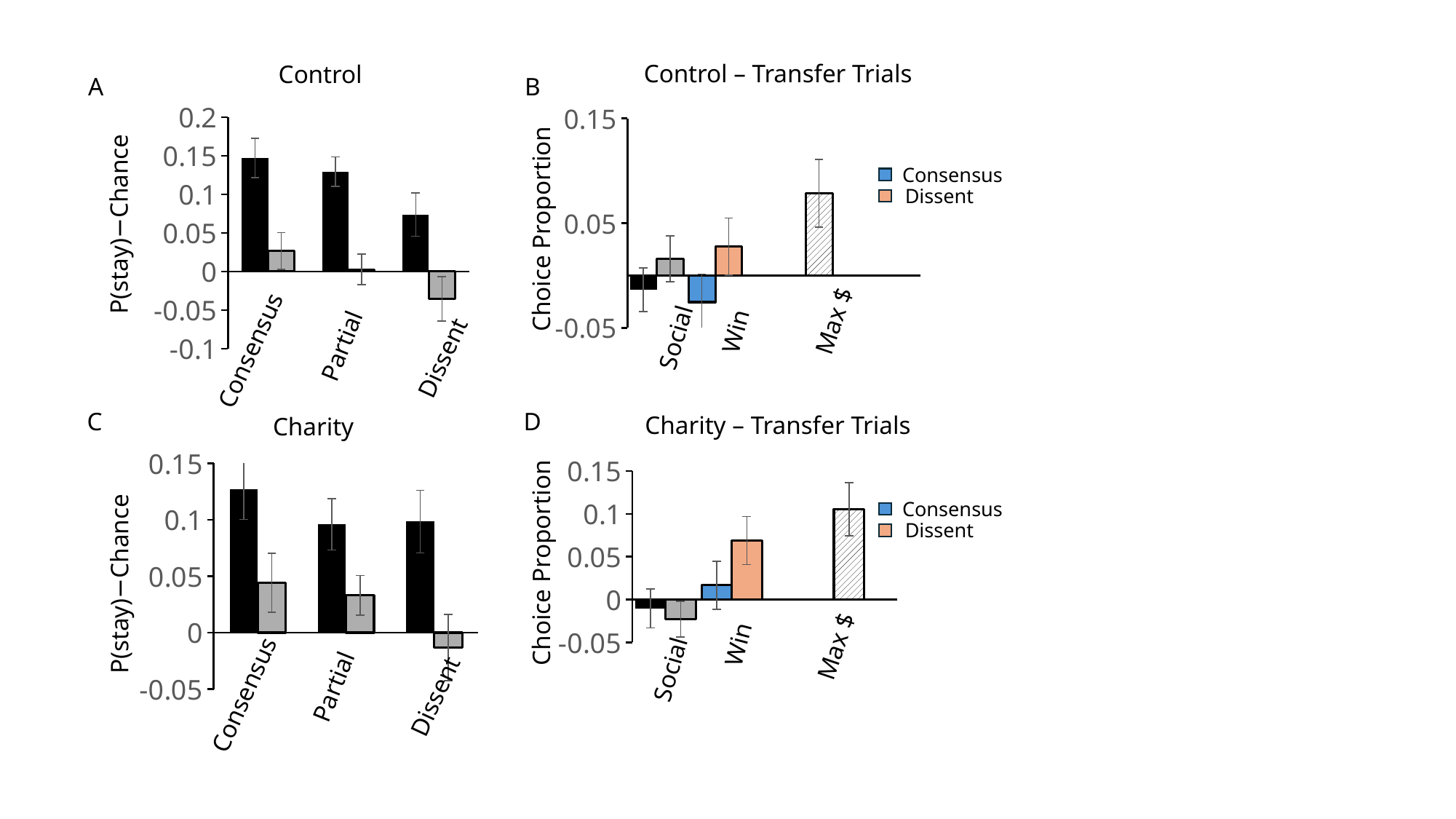
In the "Control" chart, how many categories are shown on the x axis? 3 In the "Control – Transfer Trials" chart, is the Max $ bar greater or less than 0.05? greater In the "Control – Transfer Trials" chart, what are the two legend entries? Consensus and Dissent What kind of chart is the "Control" chart? bar chart In the "Control – Transfer Trials" chart, how many series does the legend list? 2 In the "Charity" chart, which category has the lowest gray bar? Dissent In the "Control" chart, which category has the highest black bar? Consensus In the "Control" chart, is the gray bar for Dissent greater or less than 0? less In the "Charity – Transfer Trials" chart, is the Max $ bar greater or less than 0.05? greater In the "Control" chart, do the black bars rise or fall from Consensus to Dissent? fall